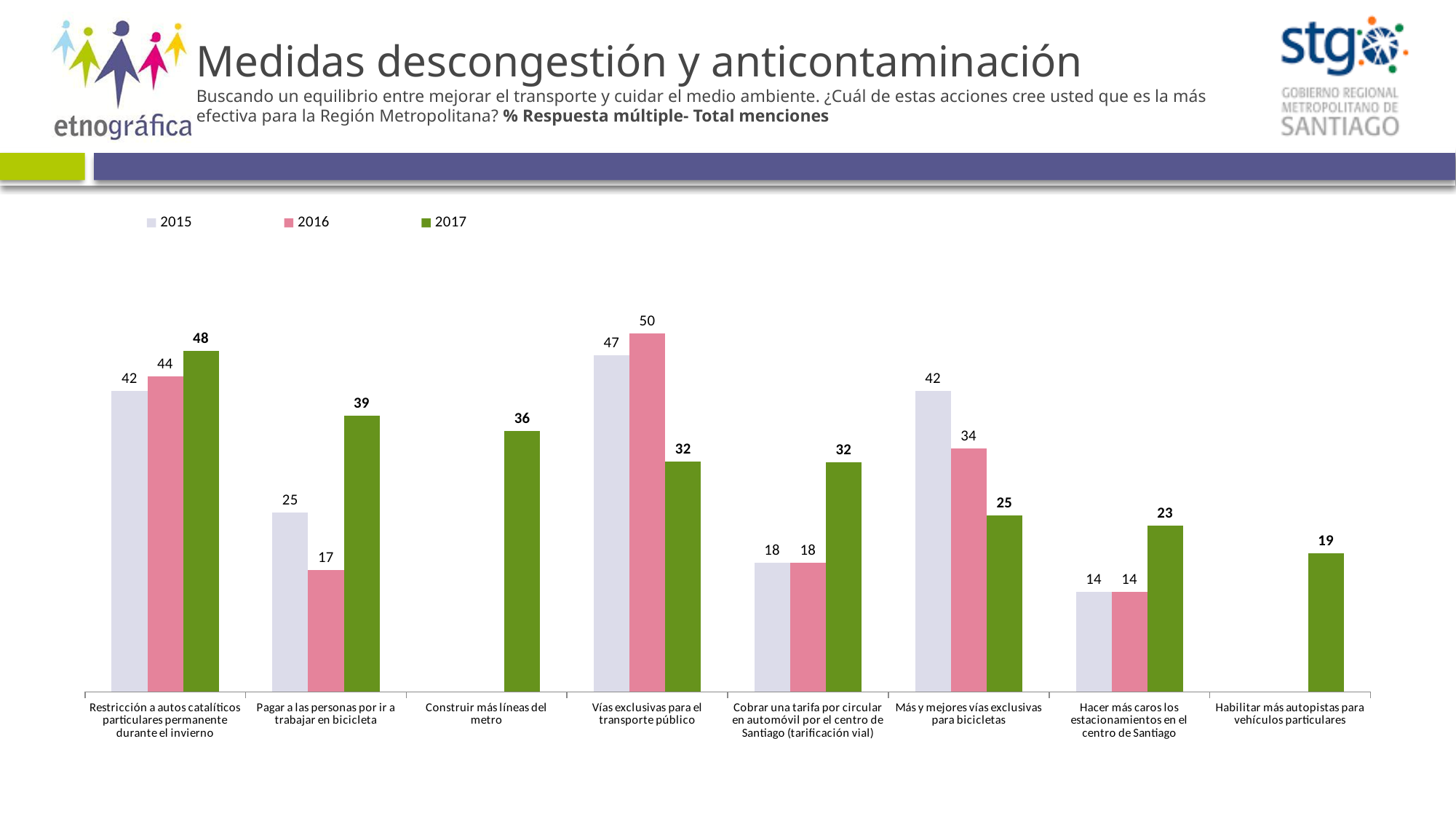
How many categories are shown on the x axis? 8 How many series does the legend list? 3 What is the difference between the 2016 and 2017 values for "Vías exclusivas para el transporte público"? 18 What is the 2016 value for "Vías exclusivas para el transporte público"? 50 Which is larger for "Pagar a las personas por ir a trabajar en bicicleta": the 2015 value or the 2016 value? 2015 What is the 2015 value for "Más y mejores vías exclusivas para bicicletas"? 42 What is the 2017 value for "Restricción a autos catalíticos particulares permanente durante el invierno"? 48 What is the 2017 value for "Construir más líneas del metro"? 36 What kind of chart is shown on the slide? Bar chart Which category has the highest 2017 value? Restricción a autos catalíticos particulares permanente durante el invierno Which category has the lowest 2017 value? Habilitar más autopistas para vehículos particulares Which series is shown in green in the legend? 2017